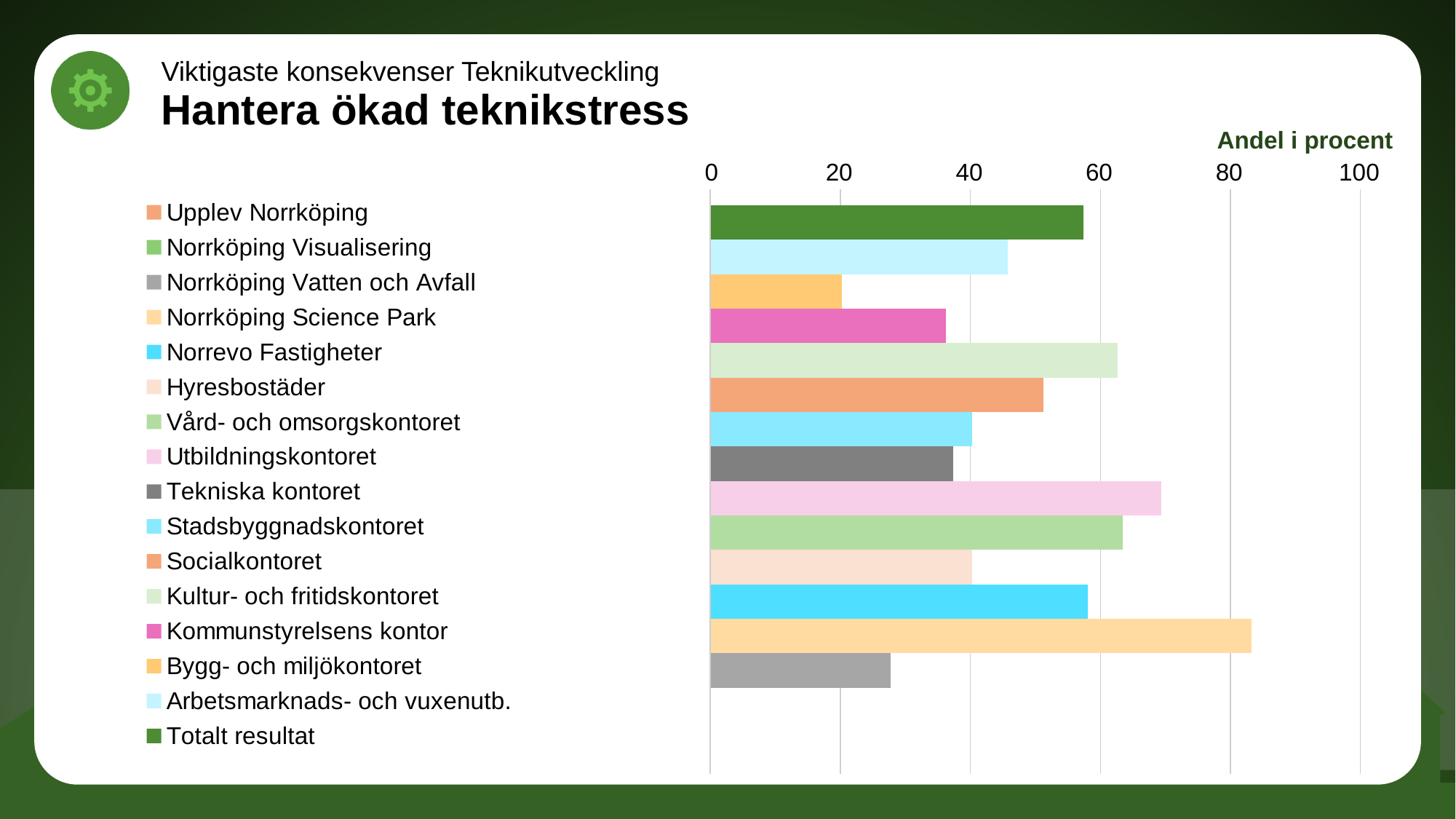
Which category has the shortest bar in the chart? Bygg- och miljökontoret Which is larger, the value for Utbildningskontoret or the value for Socialkontoret? Utbildningskontoret Is the value for Norrköping Vatten och Avfall greater or less than 40? less What is the axis title shown above the horizontal axis? Andel i procent Is the value for Totalt resultat greater or less than 40? greater How many entries does the legend list? 16 What kind of chart is shown on the slide? bar chart Is the value for Utbildningskontoret greater or less than 60? greater How many bars are plotted in the chart? 14 Which category has the longest bar in the chart? Norrköping Science Park Which is larger, the value for Norrköping Science Park or the value for Totalt resultat? Norrköping Science Park